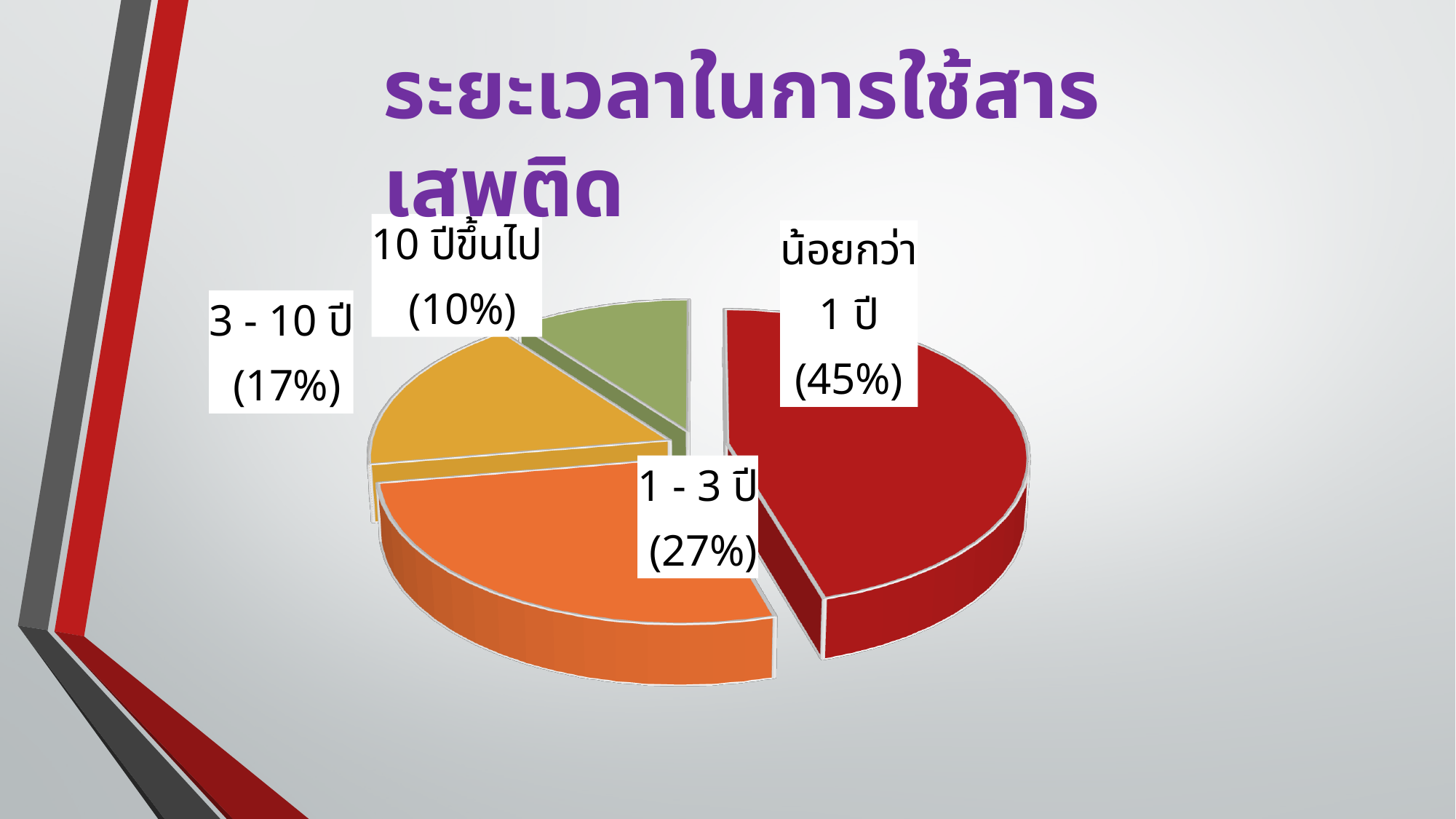
What is the difference in percentage points between the น้อยกว่า 1 ปี slice and the 1 - 3 ปี slice? 18 How many slices does the pie chart have? 4 What percentage is shown for the slice labelled 3 - 10 ปี? 17% What colour is the slice labelled น้อยกว่า 1 ปี? Red What is the title of the chart on the slide? ระยะเวลาในการใช้สารเสพติด Which slice of the pie chart has the smallest share? 10 ปีขึ้นไป What kind of chart is shown on the slide? Pie chart Which slice is larger, 3 - 10 ปี or 10 ปีขึ้นไป? 3 - 10 ปี What percentage is shown for the slice labelled 10 ปีขึ้นไป? 10% What percentage is shown for the slice labelled น้อยกว่า 1 ปี? 45% Which slice of the pie chart has the largest share? น้อยกว่า 1 ปี What percentage is shown for the slice labelled 1 - 3 ปี? 27%